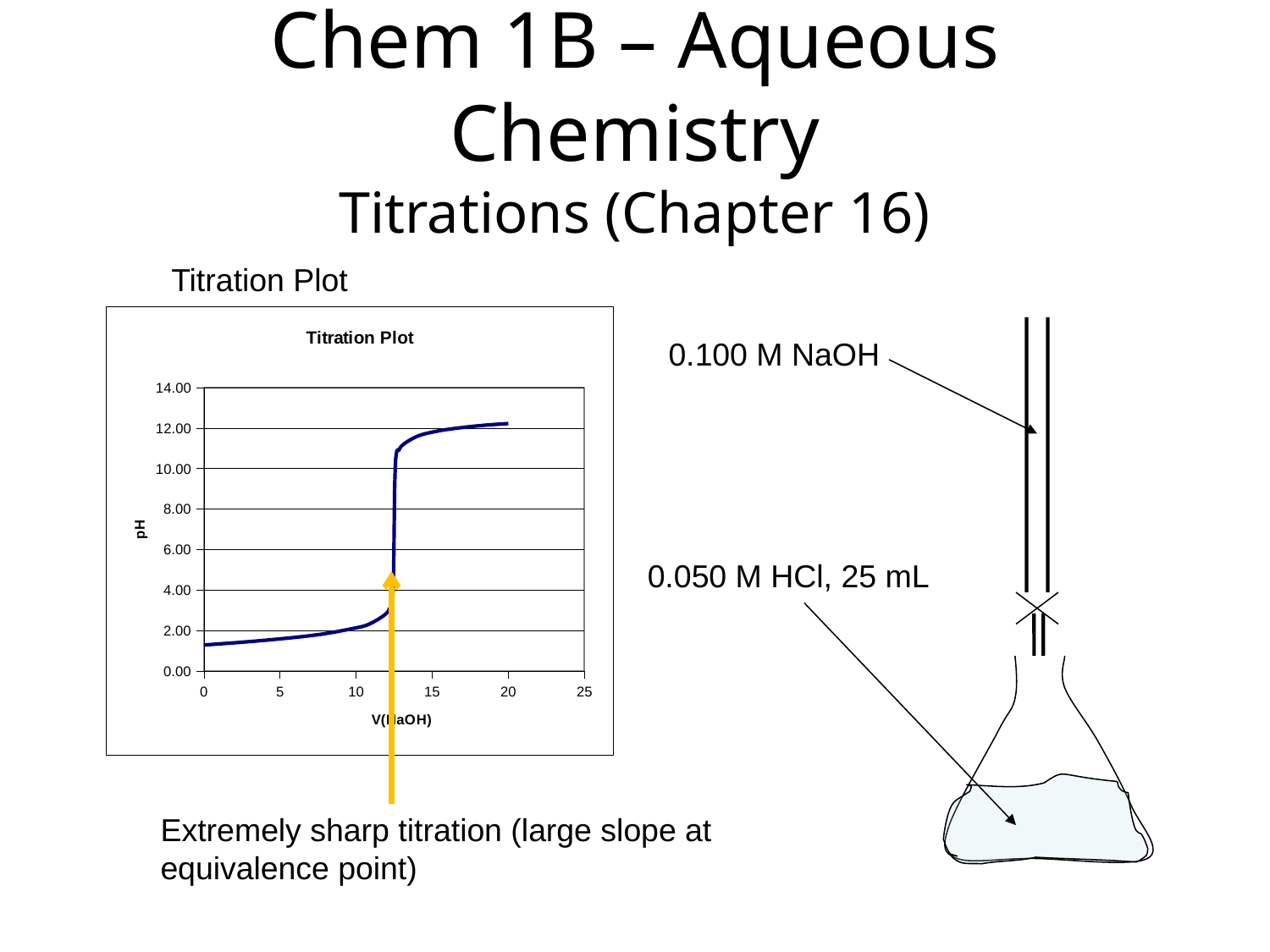
In the Titration Plot, is the pH at V(NaOH) = 15 greater or less than 8.00? greater In the Titration Plot, is the pH at V(NaOH) = 20 greater or less than 10.00? greater What kind of chart is the Titration Plot? line chart In the Titration Plot, is the pH at V(NaOH) = 5 greater or less than 4.00? less What is the label of the y axis of the Titration Plot? pH What is the title of the chart on the slide? Titration Plot What is the highest tick value shown on the y axis of the Titration Plot? 14.00 In the Titration Plot, which has the higher pH: V(NaOH) = 5 or V(NaOH) = 15? V(NaOH) = 15 Does the pH rise or fall as V(NaOH) increases along the x axis of the Titration Plot? rise